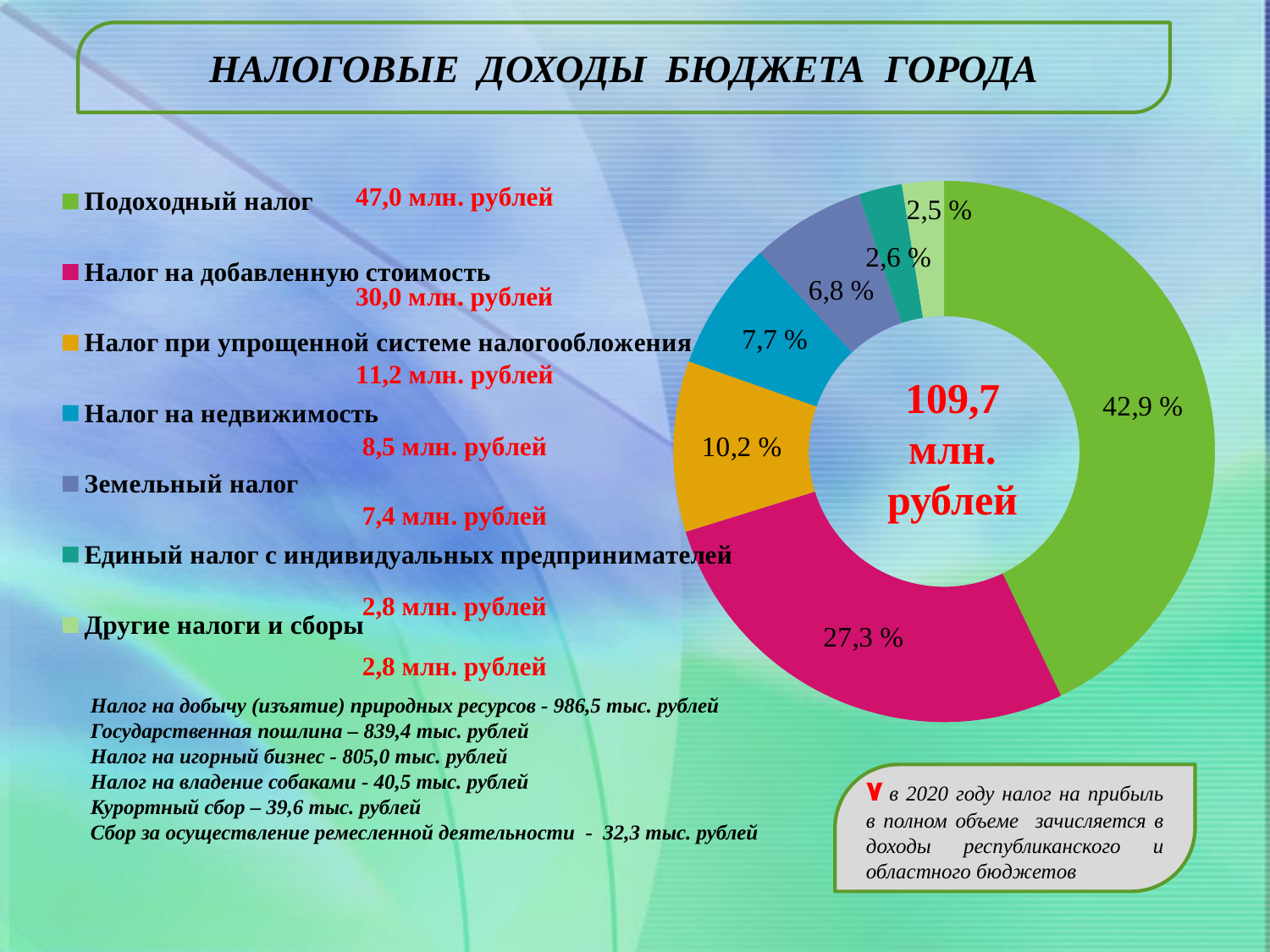
Which category has the smallest slice in the doughnut chart? Другие налоги и сборы What amount in млн. рублей is listed for Земельный налог in the legend? 7,4 млн. рублей What share of the doughnut chart does Налог на добавленную стоимость take? 27,3 % What total value is printed in the centre of the doughnut chart? 109,7 млн. рублей What share of the doughnut chart does Подоходный налог take? 42,9 % Which slice is larger: Земельный налог or Налог на недвижимость? Налог на недвижимость What percentage is shown for Налог на недвижимость? 7,7 % How many categories does the legend list? 7 Which category has the largest slice in the doughnut chart? Подоходный налог What percentage is shown for the yellow slice (Налог при упрощенной системе налогообложения)? 10,2 % What is the difference in percentage points between the Подоходный налог slice (42,9 %) and the Налог на добавленную стоимость slice (27,3 %)? 15,6 What kind of chart is shown on the slide? doughnut (pie) chart